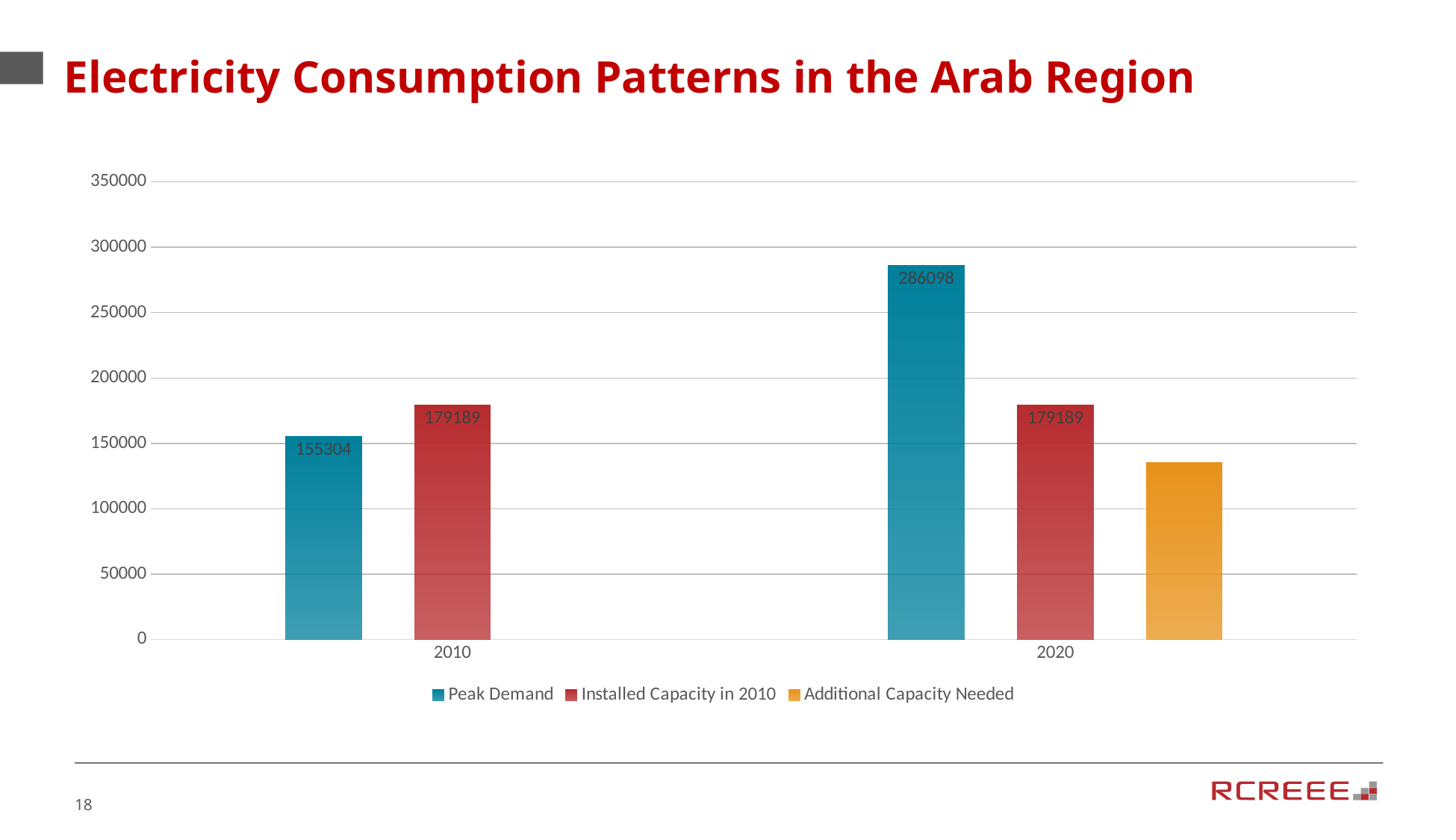
How many series does the legend list? 3 What is the Peak Demand value for 2020? 286098 What is the Peak Demand value for 2010? 155304 Is the value for Additional Capacity Needed in 2020 greater or less than 100000? greater By how much does Peak Demand in 2020 exceed Peak Demand in 2010? 130794 Which bar has the highest value on the chart? Peak Demand in 2020 What kind of chart is shown on the slide? bar chart How many year categories are shown on the x axis? 2 For 2010, which is larger: Peak Demand or Installed Capacity in 2010? Installed Capacity in 2010 What is the difference between Installed Capacity in 2010 and Peak Demand for the 2010 category? 23885 What is the Installed Capacity in 2010 value shown for the 2020 category? 179189 Is the value for Additional Capacity Needed in 2020 greater or less than 150000? less